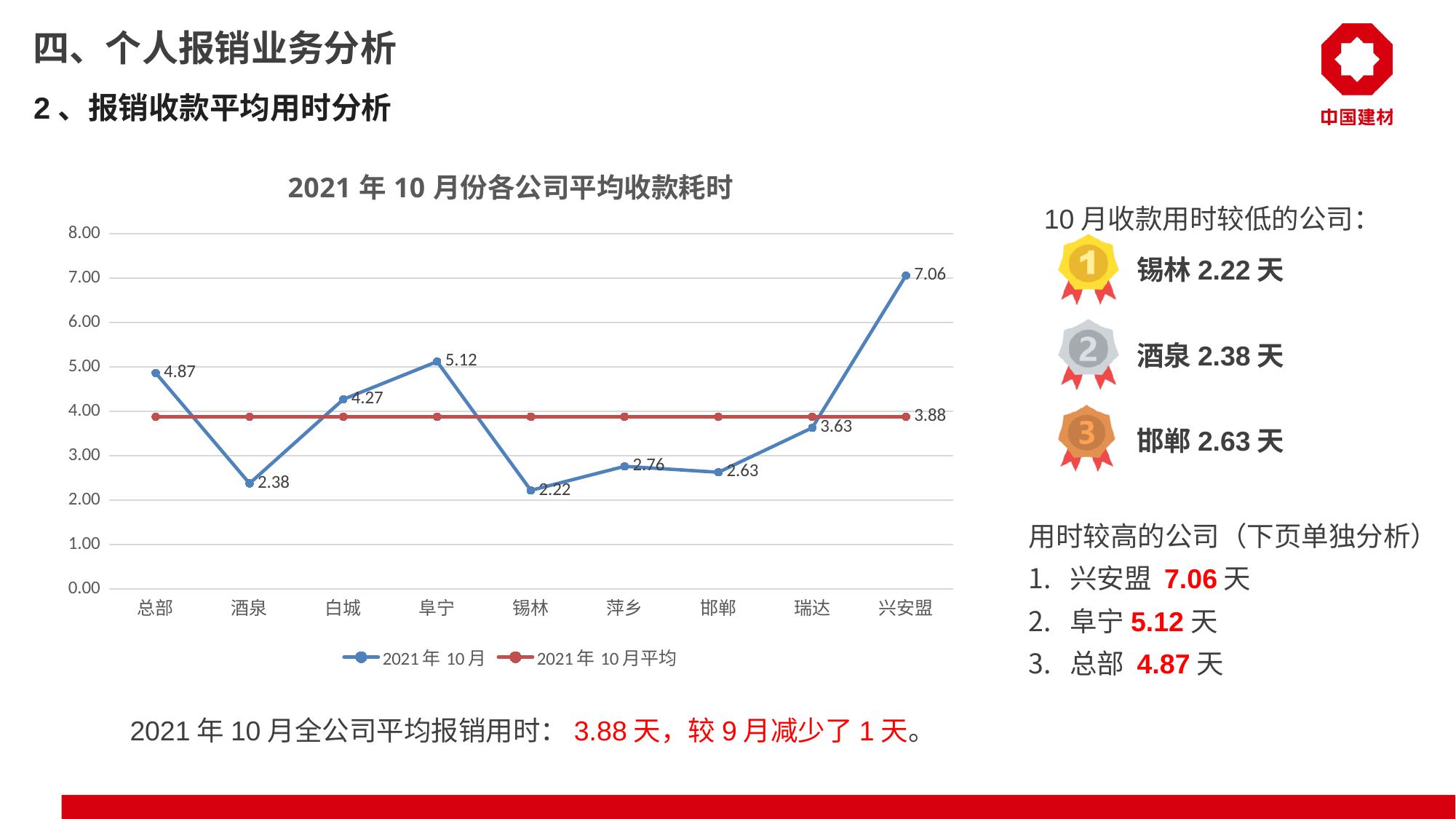
Which is larger in the 2021年10月 series, 阜宁 or 总部? 阜宁 What kind of chart is shown on the slide? line chart Which company has the lowest value in the 2021年10月 series? 锡林 How many series does the legend list? 2 What is the value for 锡林 in the 2021年10月 series? 2.22 Which company has the highest value in the 2021年10月 series? 兴安盟 What is the value for 兴安盟 in the 2021年10月 series? 7.06 What is the title of the chart? 2021年10月份各公司平均收款耗时 Is the value for 瑞达 in the 2021年10月 series greater or less than 4.00? less What is the value of the 2021年10月平均 line? 3.88 How many companies are shown on the x axis? 9 What is the difference between the values for 兴安盟 and 锡林 in the 2021年10月 series? 4.84